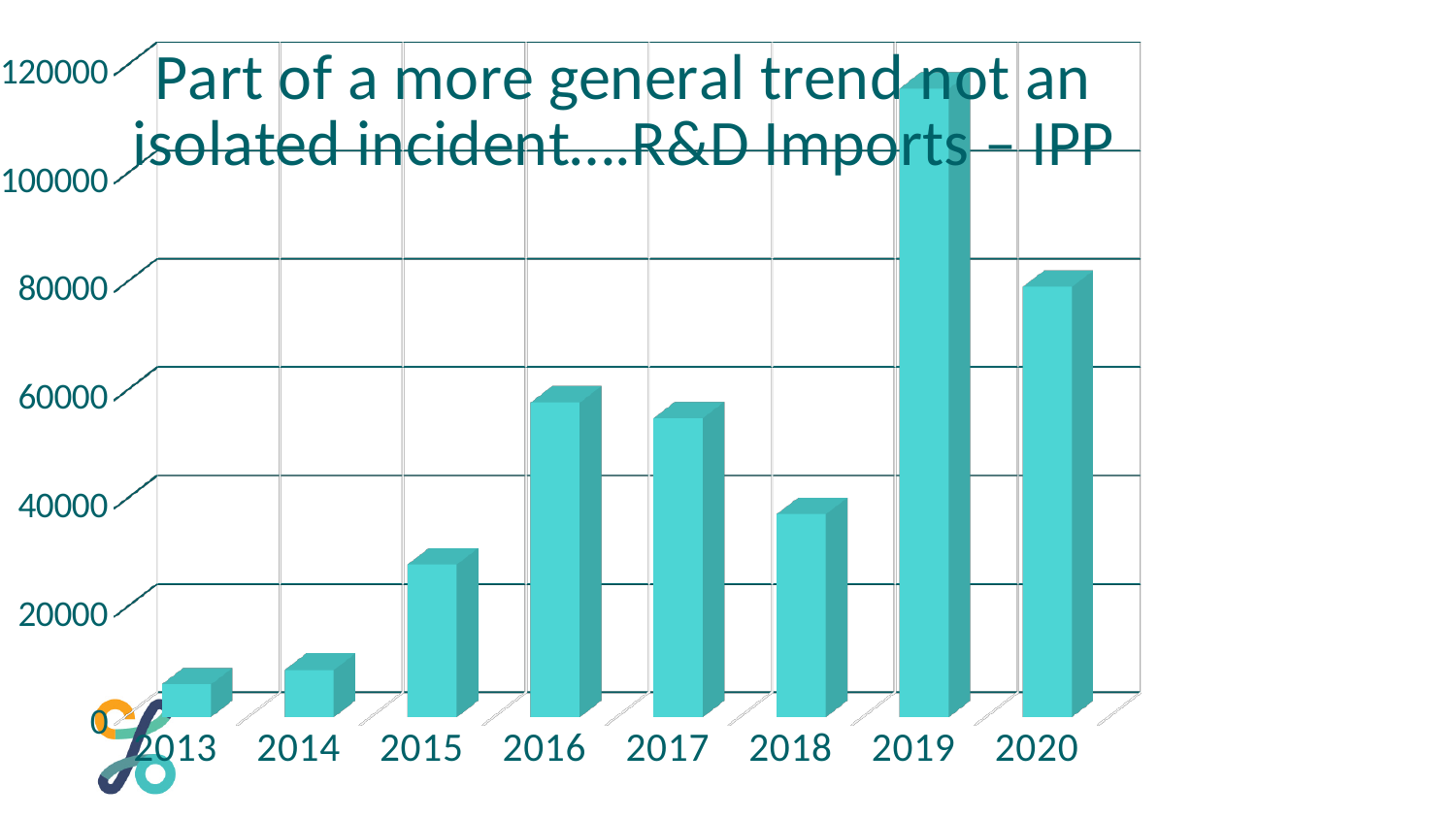
Does the value rise or fall from 2019 to 2020? fall Which year has the highest value in the chart? 2019 Is the value for 2013 greater or less than 20000? less How many years are shown on the x axis of the chart? 8 Is the value for 2018 greater or less than 40000? less What kind of chart is shown on the slide? bar chart Is the value for 2015 greater or less than 20000? greater Which is larger, the value for 2018 or the value for 2015? 2018 Which year has the lowest value in the chart? 2013 Which is larger, the value for 2016 or the value for 2017? 2016